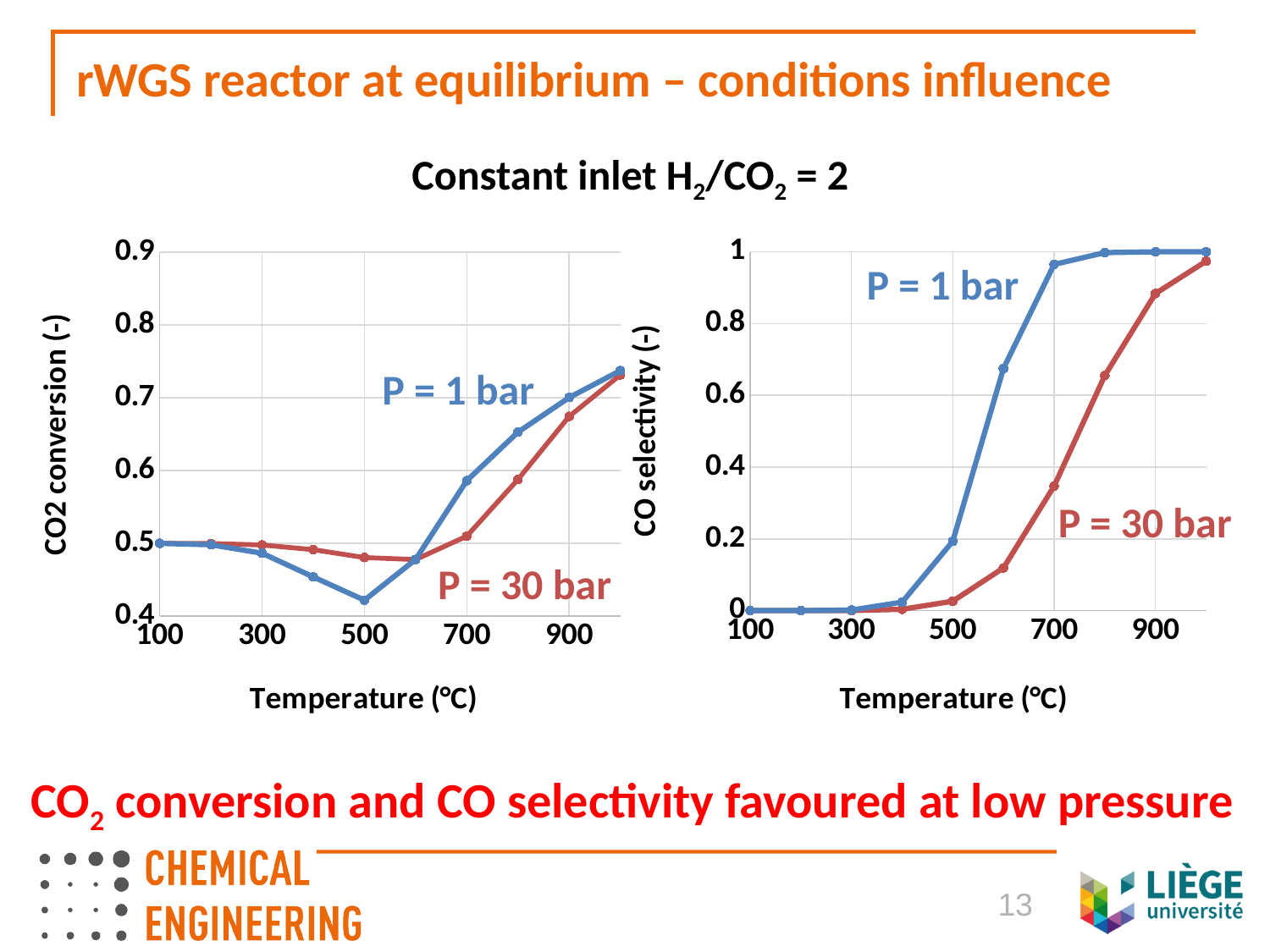
On the CO2 conversion chart on the left, which series has the higher value at 500 °C, P = 1 bar or P = 30 bar? P = 30 bar What is the x-axis label of the CO selectivity chart on the right? Temperature (°C) How many series are plotted on the CO selectivity chart on the right? 2 On the CO selectivity chart on the right, does the P = 30 bar series rise or fall as temperature increases from 500 °C to 1000 °C? rise On the CO selectivity chart on the right, is the value for P = 1 bar at 700 °C greater or less than 0.8? greater What are the two series labelled on the CO2 conversion chart on the left? P = 1 bar and P = 30 bar On the CO2 conversion chart on the left, at which temperature does the P = 1 bar series reach its lowest value? 500 °C On the CO2 conversion chart on the left, is the value for P = 1 bar at 500 °C greater or less than 0.5? less On the CO selectivity chart on the right, is the value for P = 30 bar at 600 °C greater or less than 0.2? less On the CO selectivity chart on the right, which series has the higher value at 700 °C, P = 1 bar or P = 30 bar? P = 1 bar What kind of chart is the CO2 conversion chart on the left? line chart